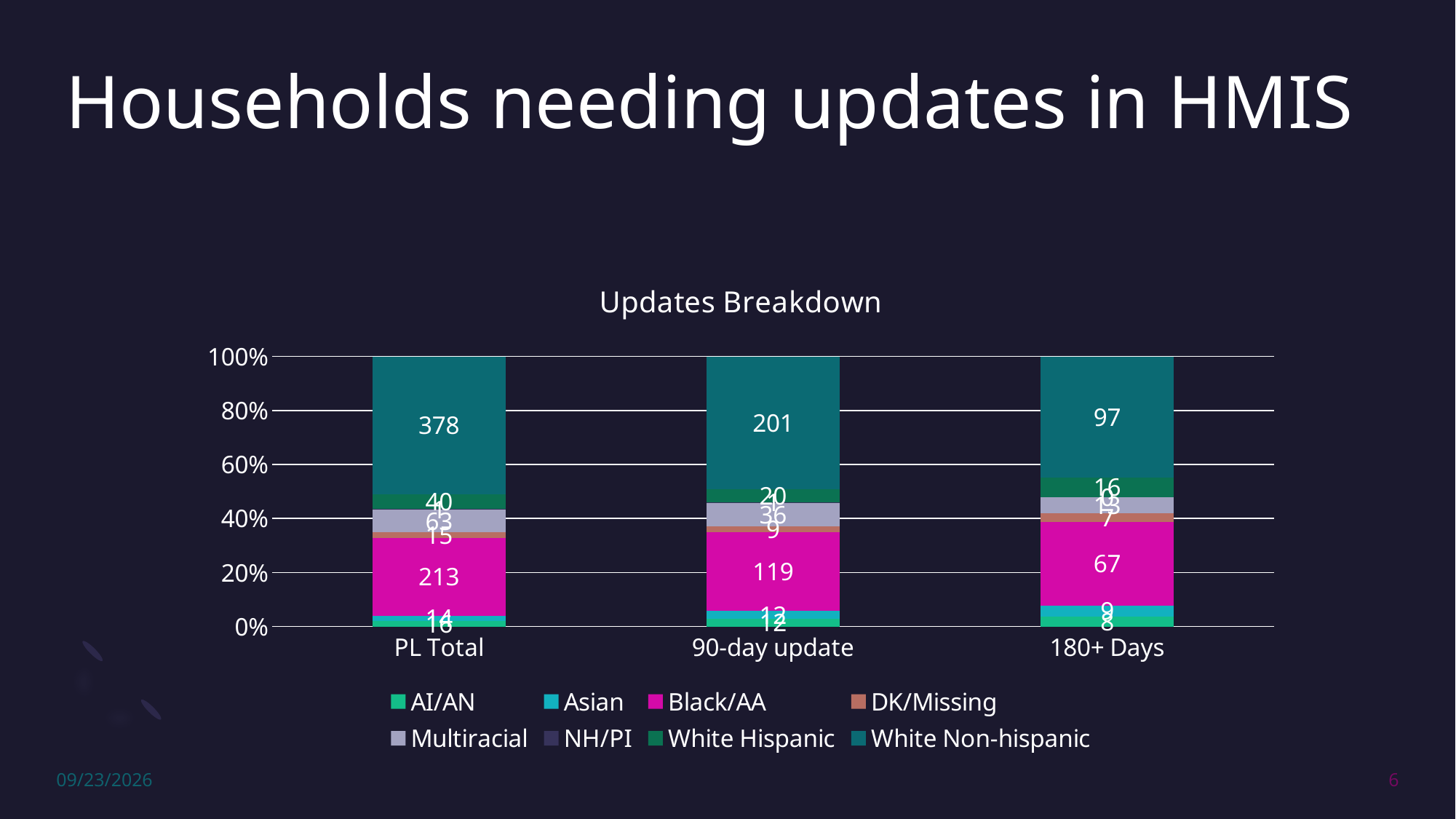
In the Updates Breakdown chart, what is the value for White Non-hispanic in the PL Total bar? 378 In the Updates Breakdown chart, what is the value for Black/AA in the 180+ Days bar? 67 How many series does the legend of the Updates Breakdown chart list? 8 What kind of chart is the Updates Breakdown chart? Stacked bar chart In the Updates Breakdown chart, what is the value for DK/Missing in the 180+ Days bar? 7 In the Updates Breakdown chart, what is the value for White Non-hispanic in the 180+ Days bar? 97 In the Updates Breakdown chart, which series has the largest value in the PL Total bar? White Non-hispanic How many categories are shown on the x axis of the Updates Breakdown chart? 3 In the Updates Breakdown chart, which is larger in the 90-day update bar: White Non-hispanic or Black/AA? White Non-hispanic In the Updates Breakdown chart, what is the value for White Hispanic in the PL Total bar? 40 In the Updates Breakdown chart, what is the value for Black/AA in the 90-day update bar? 119 In the Updates Breakdown chart, what is the difference between the White Non-hispanic values for PL Total and 90-day update? 177